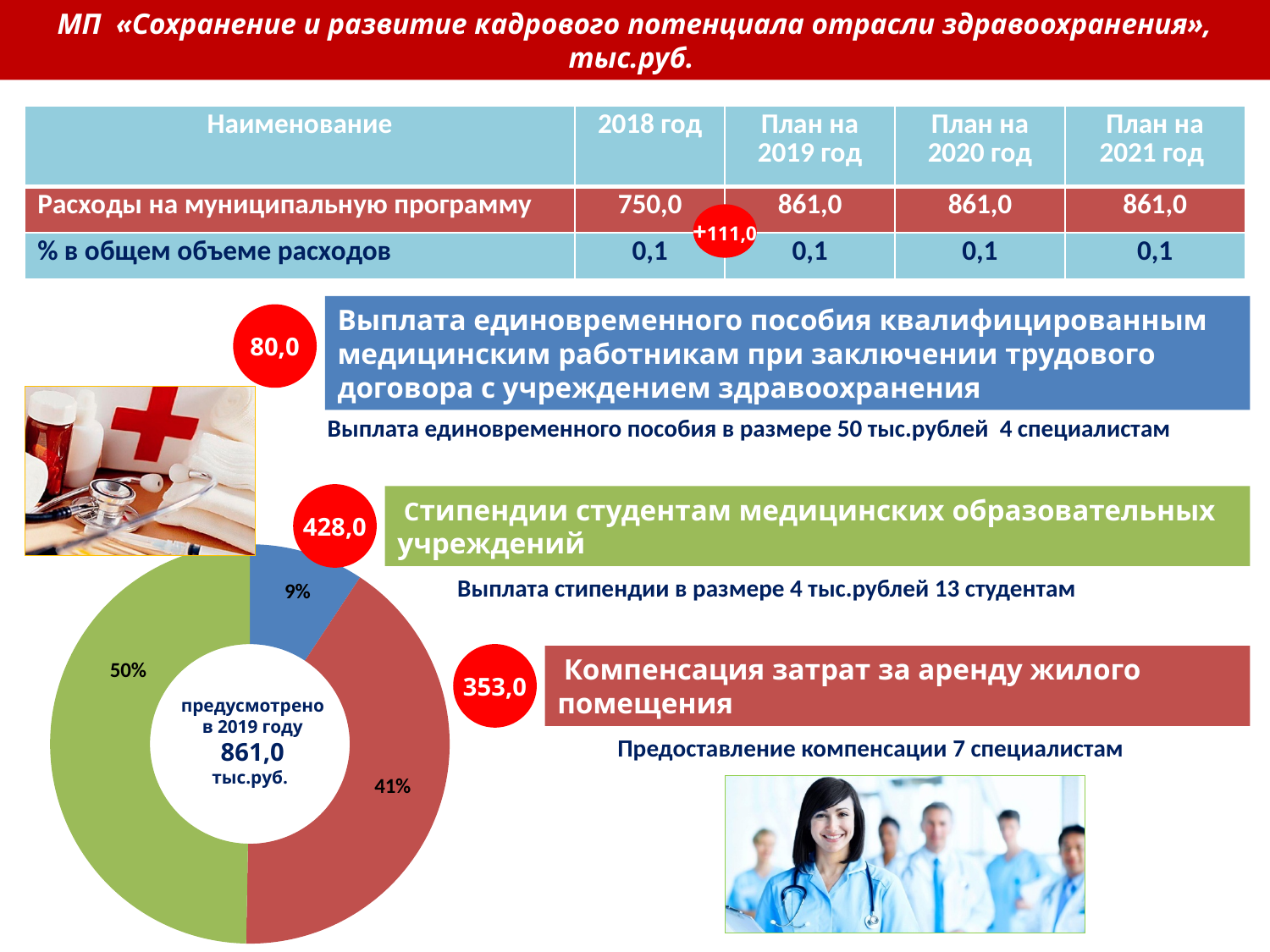
What share does the blue slice of the doughnut chart represent? 9% What is the difference in percentage points between the green slice and the red slice of the doughnut chart? 9 percentage points What share does the green slice of the doughnut chart represent? 50% What is the smallest share shown on the doughnut chart? 9% What total amount is written in the centre of the doughnut chart? 861,0 тыс.руб. What kind of chart is shown on the slide? Doughnut (pie) chart What share does the red slice of the doughnut chart represent? 41% What is the difference in percentage points between the red slice and the blue slice of the doughnut chart? 32 percentage points Which year does the text in the centre of the doughnut chart refer to? 2019 What is the largest share shown on the doughnut chart? 50% Which slice of the doughnut chart is larger, the green one or the red one? The green one (50%) How many slices does the doughnut chart have? 3